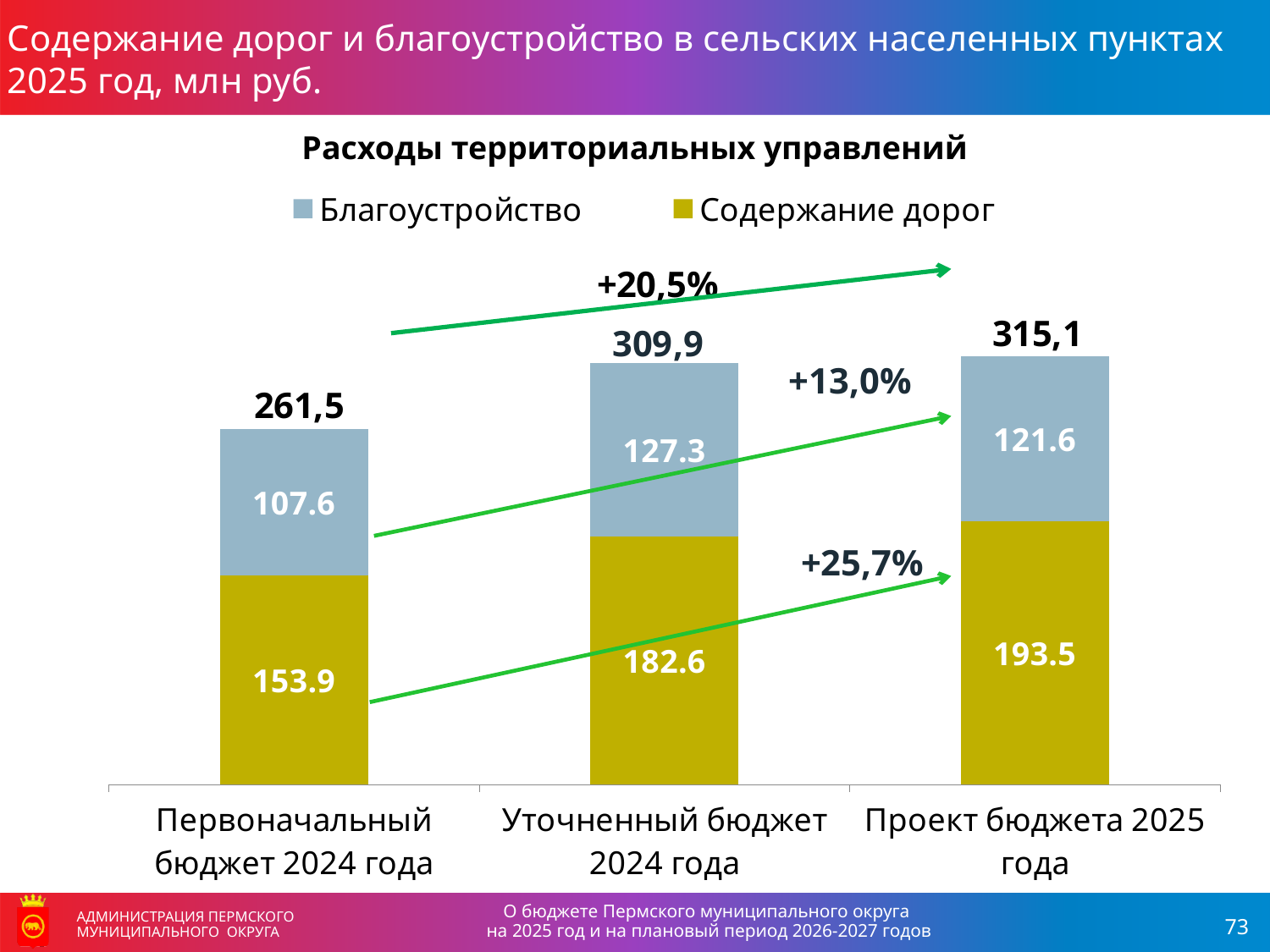
What is the value of Благоустройство for Уточненный бюджет 2024 года? 127.3 How many categories are shown on the x axis? 3 What kind of chart is shown on the slide? Stacked bar chart Which category has the lowest value for Благоустройство? Первоначальный бюджет 2024 года What is the difference between Содержание дорог for Проект бюджета 2025 года and for Уточненный бюджет 2024 года? 10.9 What is the total shown above the bar for Проект бюджета 2025 года? 315,1 What is the value of Содержание дорог for Первоначальный бюджет 2024 года? 153.9 Which is larger: Благоустройство for Уточненный бюджет 2024 года or for Проект бюджета 2025 года? Уточненный бюджет 2024 года How many series does the legend list? 2 Which category has the highest value for Содержание дорог? Проект бюджета 2025 года What is the value of Благоустройство for Проект бюджета 2025 года? 121.6 What is the total shown above the bar for Первоначальный бюджет 2024 года? 261,5